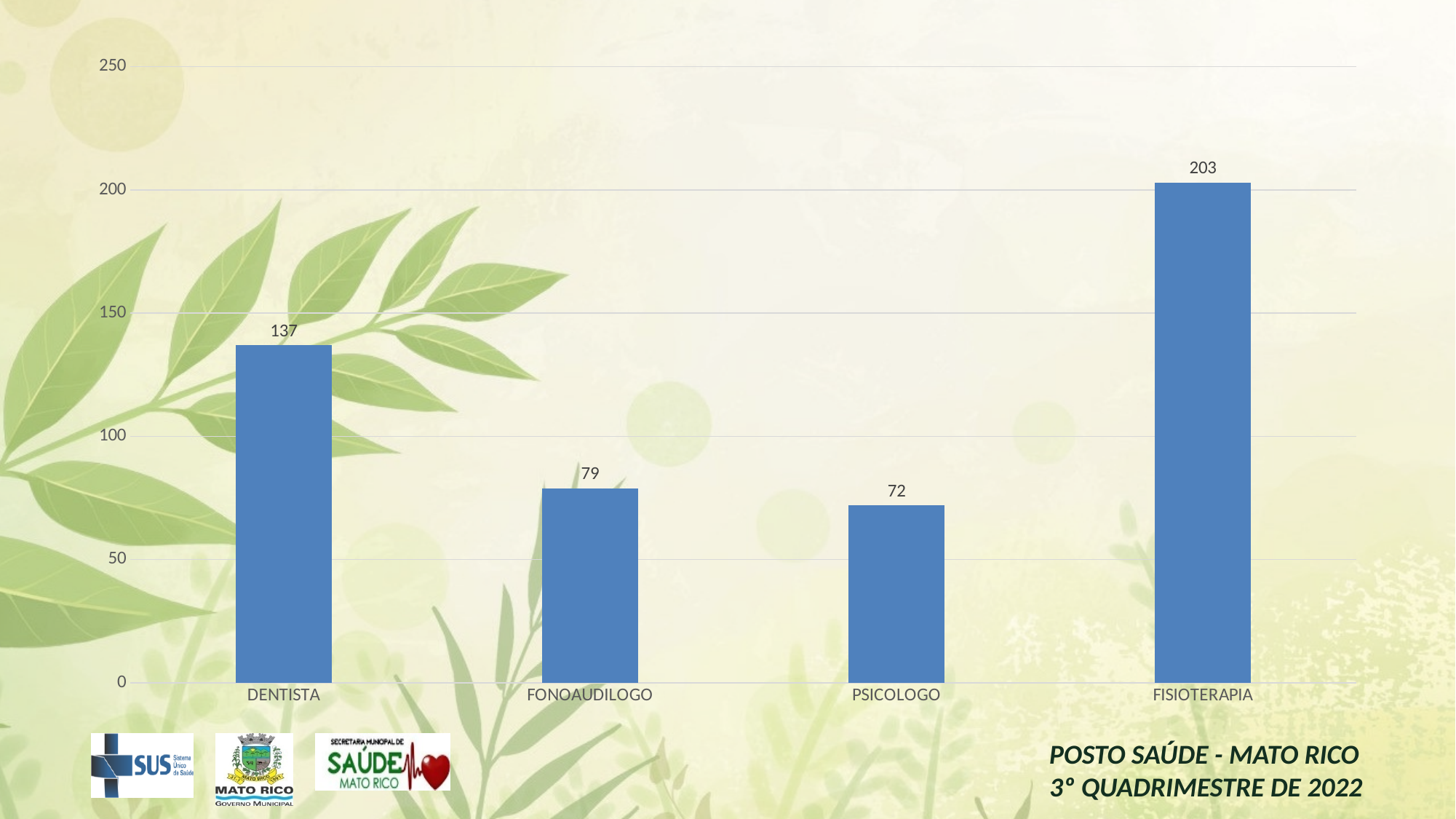
What kind of chart is shown on the slide? bar chart What is the difference between the values for FISIOTERAPIA and DENTISTA? 66 What is the value for FONOAUDILOGO? 79 What is the value for DENTISTA? 137 What is the value for FISIOTERAPIA? 203 Is the value for FISIOTERAPIA greater or less than 200? greater Which category has the highest value? FISIOTERAPIA What is the value for PSICOLOGO? 72 What is the difference between the values for FONOAUDILOGO and PSICOLOGO? 7 How many categories are shown on the chart? 4 Which category has the lowest value? PSICOLOGO Which is larger, the value for DENTISTA or the value for FONOAUDILOGO? DENTISTA